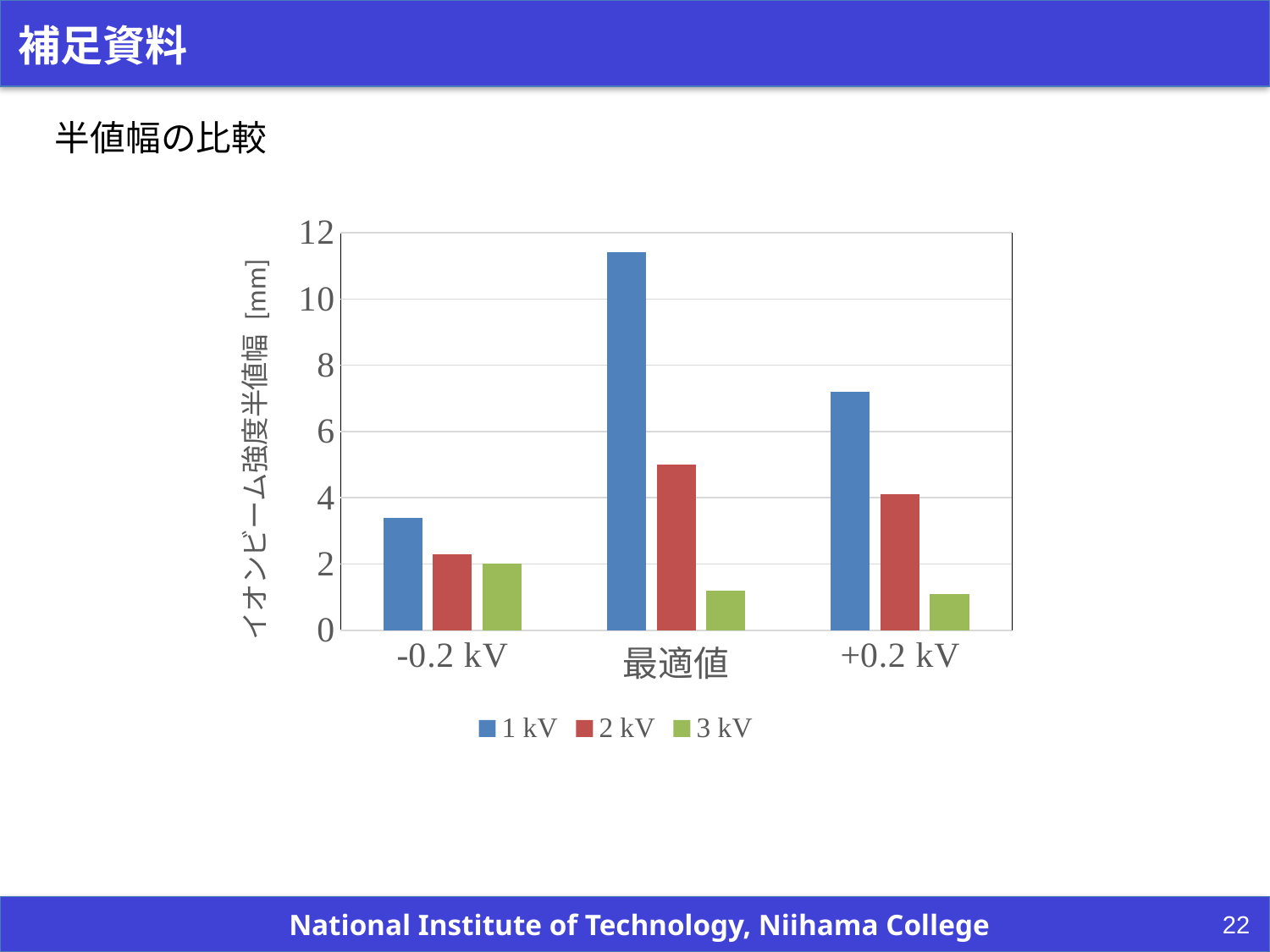
What is the label of the vertical axis? イオンビーム強度半値幅 [mm] Which series and category has the tallest bar in the chart? 1 kV at 最適値 Within the -0.2 kV category, which series has the highest value? 1 kV Is the value for 1 kV at -0.2 kV greater or less than 4? less Within the 最適値 category, which series has the lowest value? 3 kV Which is larger: the 1 kV value at 最適値 or the 1 kV value at +0.2 kV? 最適値 How many categories are shown on the x axis? 3 Is the value for 1 kV at +0.2 kV greater or less than 6? greater Is the value for 1 kV at 最適値 greater or less than 10? greater What kind of chart is shown on the slide? bar chart How many series does the legend list? 3